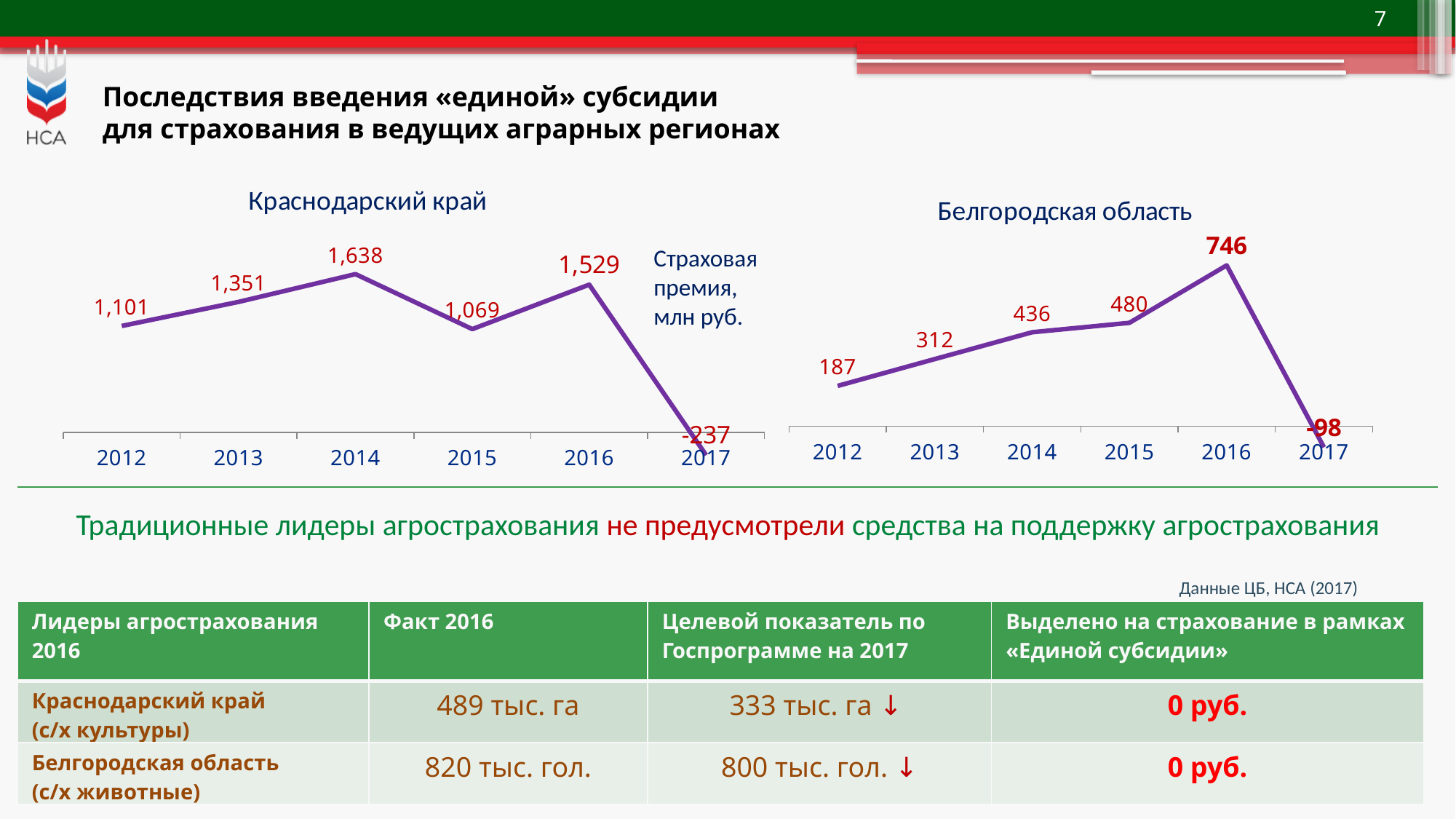
In the Краснодарский край chart, what is the difference between the 2014 and 2015 values? 569 In the Белгородская область chart, what is the difference between the 2016 and 2015 values? 266 In the Краснодарский край chart, which year has the highest value? 2014 In the Краснодарский край chart, what is the value for 2012? 1,101 In the Белгородская область chart, which year has the lowest value? 2017 How many years are plotted in the Белгородская область chart? 6 In the Белгородская область chart, what is the value for 2016? 746 In the Краснодарский край chart, what is the value for 2014? 1,638 In the Белгородская область chart, what is the value for 2017? -98 In the Краснодарский край chart, which is larger, the value for 2013 or the value for 2016? 2016 In the Белгородская область chart, do the values rise or fall from 2012 to 2016? Rise What type of chart is the Краснодарский край chart? Line chart